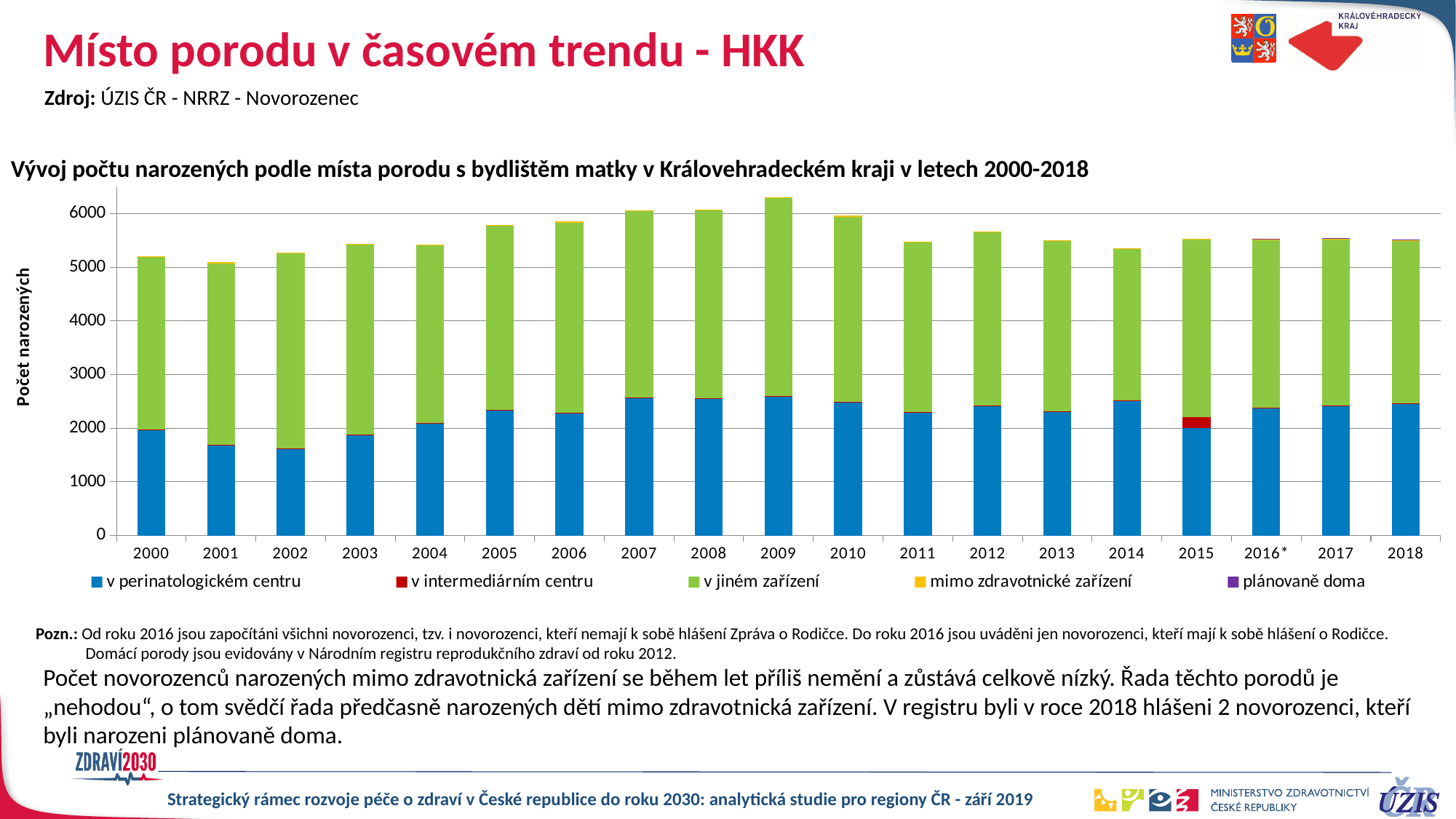
How many series does the chart legend list? 5 Is the total number of births in 2014 greater or less than 5000? greater How many years (categories) are shown on the x axis of the chart? 19 What kind of chart is shown on the slide? stacked bar chart Is the value for 'v perinatologickém centru' in 2009 greater or less than 2000? greater Is the total number of births in 2009 greater or less than 6000? greater Which year has the highest total number of births in the chart? 2009 Do the total numbers of births rise or fall from 2009 to 2011? fall Which series is shown in blue in the chart? v perinatologickém centru Which year has a larger total number of births, 2007 or 2011? 2007 What is the label of the y axis of the chart? Počet narozených